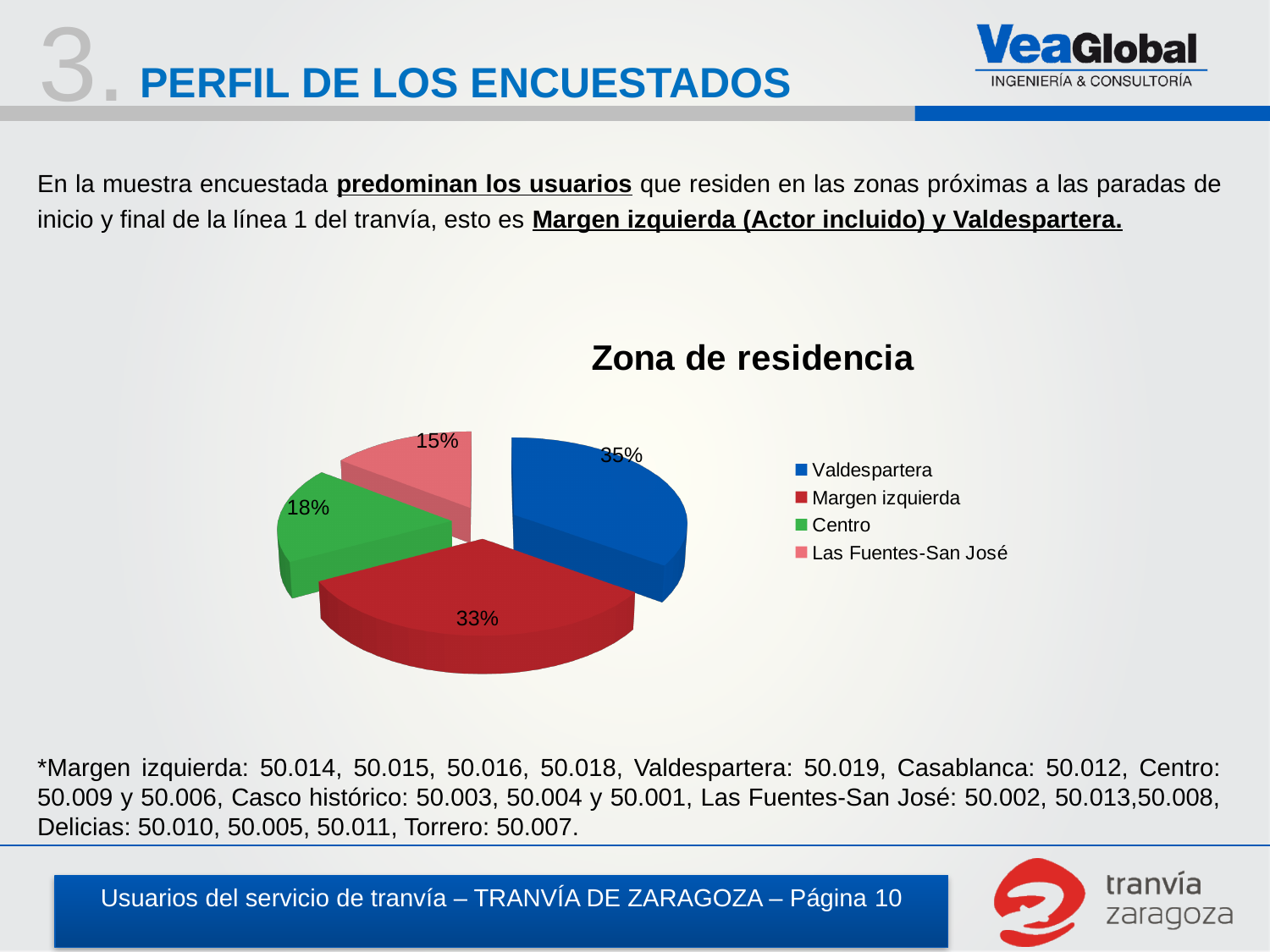
What is the title of the chart? Zona de residencia Which zone of residence has the smallest share in the chart? Las Fuentes-San José What percentage of respondents reside in Centro? 18% How many zones of residence are shown in the chart? 4 What colour is the slice for Margen izquierda? Red Which has a larger share, Centro or Las Fuentes-San José? Centro Which zone of residence has the largest share in the chart? Valdespartera What percentage of respondents reside in Margen izquierda? 33% What type of chart is shown on the slide? Pie chart What is the difference in percentage points between Valdespartera and Centro? 17 What percentage of respondents reside in Las Fuentes-San José? 15% What percentage of respondents reside in Valdespartera? 35%